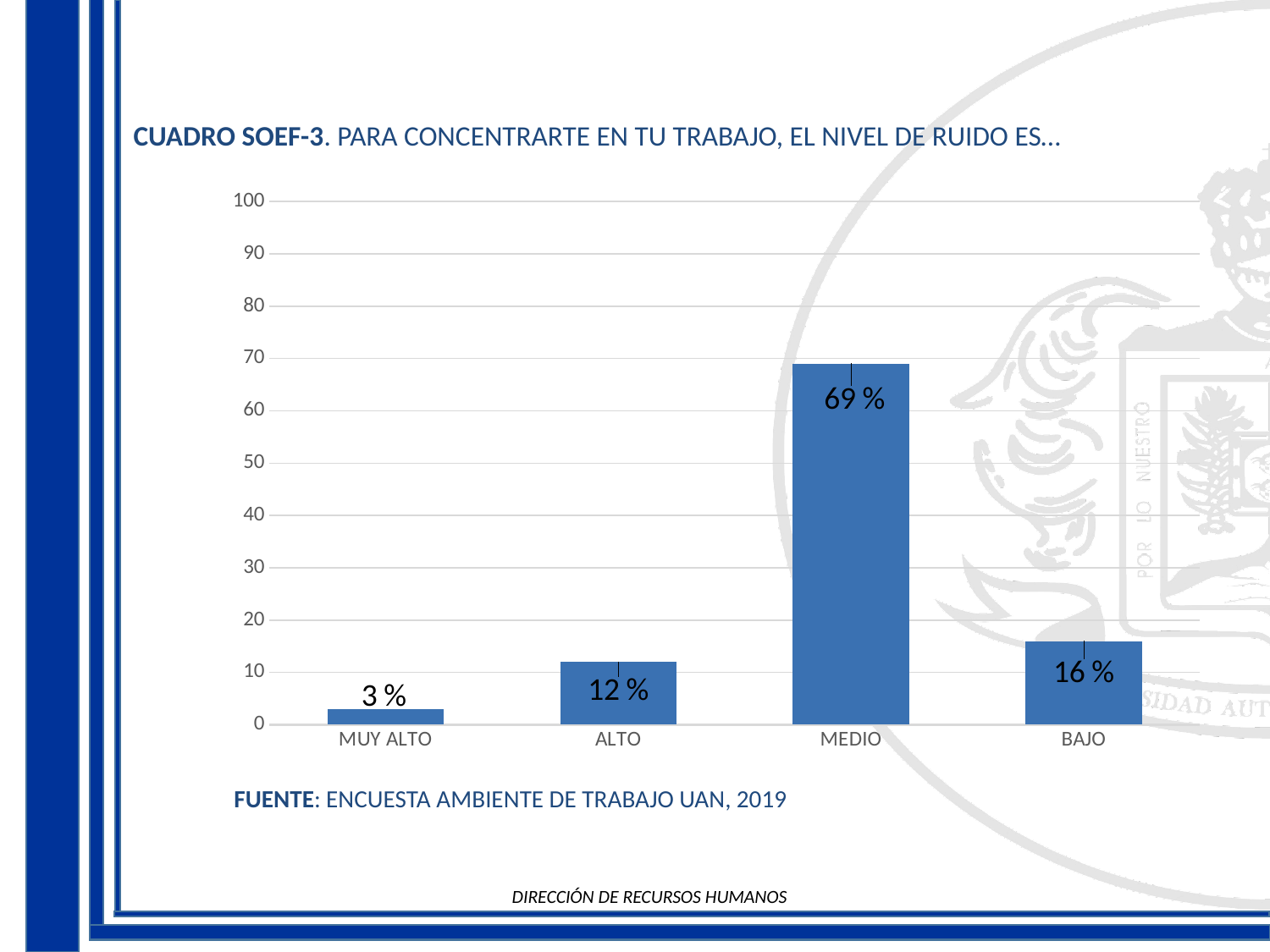
What is the value for BAJO? 16 % Which category has the lowest value? MUY ALTO What is the difference between the values for MEDIO and BAJO? 53 % What is the value for ALTO? 12 % What is the value for MEDIO? 69 % What is the value for MUY ALTO? 3 % Which category has the highest value? MEDIO What source is cited below the chart? ENCUESTA AMBIENTE DE TRABAJO UAN, 2019 Which is larger, the value for ALTO or the value for BAJO? BAJO Is the value for MEDIO greater or less than 60? greater How many categories are shown on the x axis? 4 What kind of chart is shown on the slide? bar chart